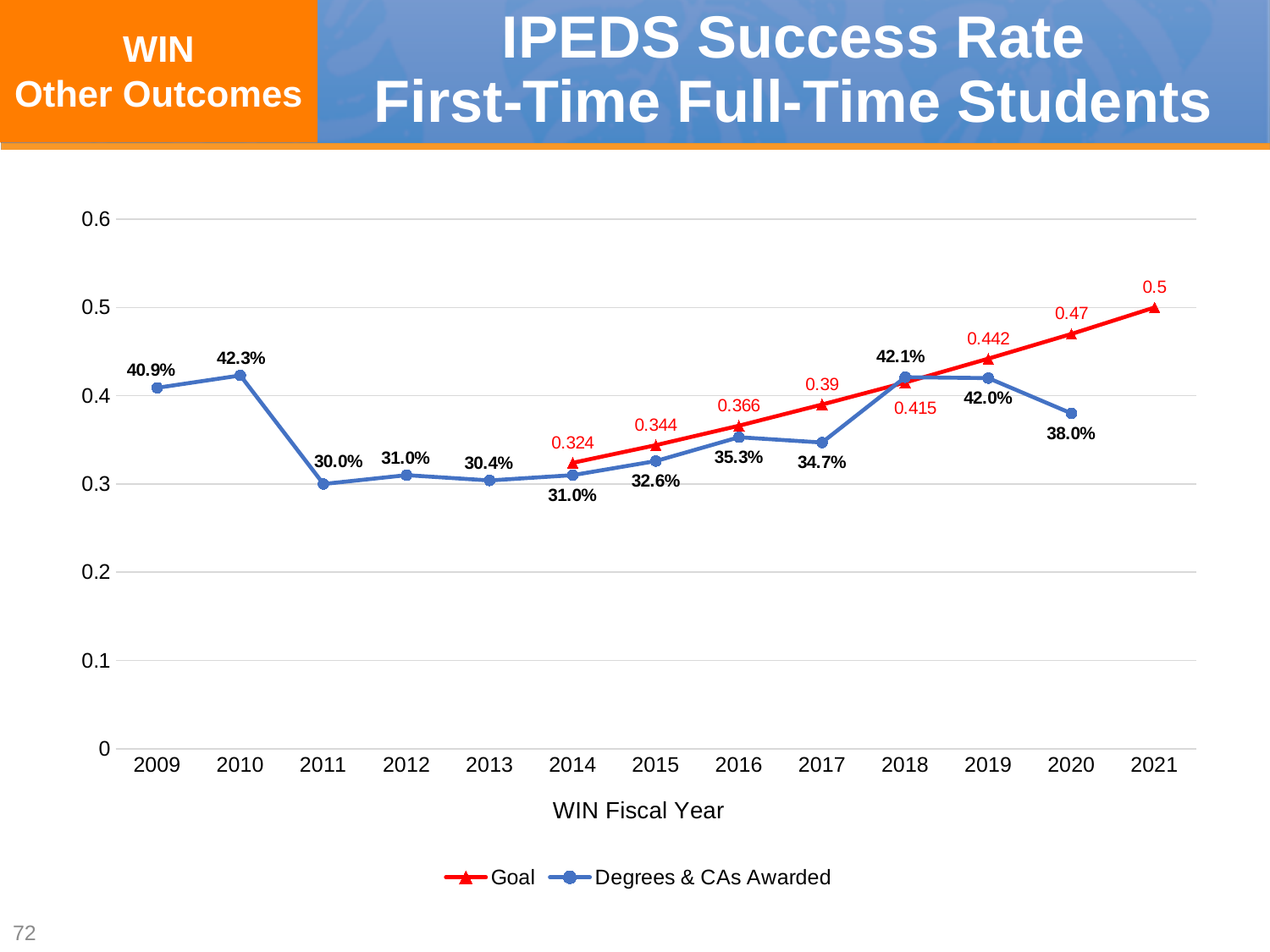
What is the difference between the Degrees & CAs Awarded values for 2010 and 2011? 12.3 percentage points What is the Goal value for 2017? 0.39 Does the Goal series rise or fall from 2014 to 2021? Rises How many years are shown on the x axis? 13 Is the Degrees & CAs Awarded value for 2020 greater or less than 0.4? less In which year is the Degrees & CAs Awarded value lowest? 2011 Which is larger, the Degrees & CAs Awarded value for 2016 or for 2017? 2016 What is the Goal value for 2021? 0.5 What kind of chart is shown on the slide? Line chart In which year is the Degrees & CAs Awarded value highest? 2010 How many series does the legend list? 2 What is the Degrees & CAs Awarded value for 2010? 42.3%